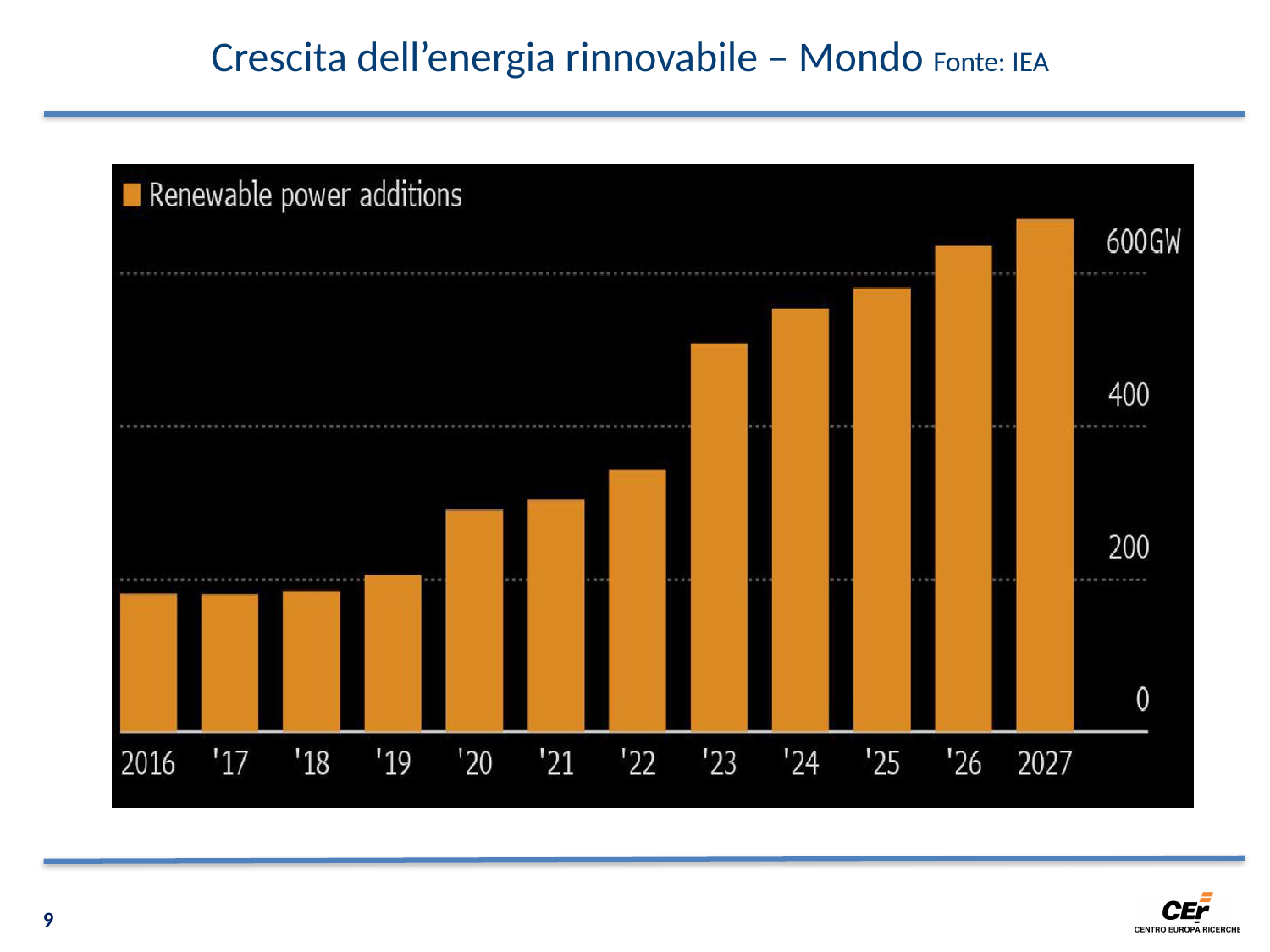
Is the value for '25 greater or less than 600 GW? less How many series does the chart legend list? 1 What is the name of the series shown in the chart legend? Renewable power additions Do renewable power additions generally rise or fall from 2016 to 2027? rise Which year has the highest renewable power additions? 2027 Is the value for 2016 greater or less than 200 GW? less How many years are shown on the x axis of the chart? 12 What kind of chart is shown on the slide? bar chart Is the value for '22 greater or less than 400 GW? less Which is larger, the value for '22 or the value for '23? '23